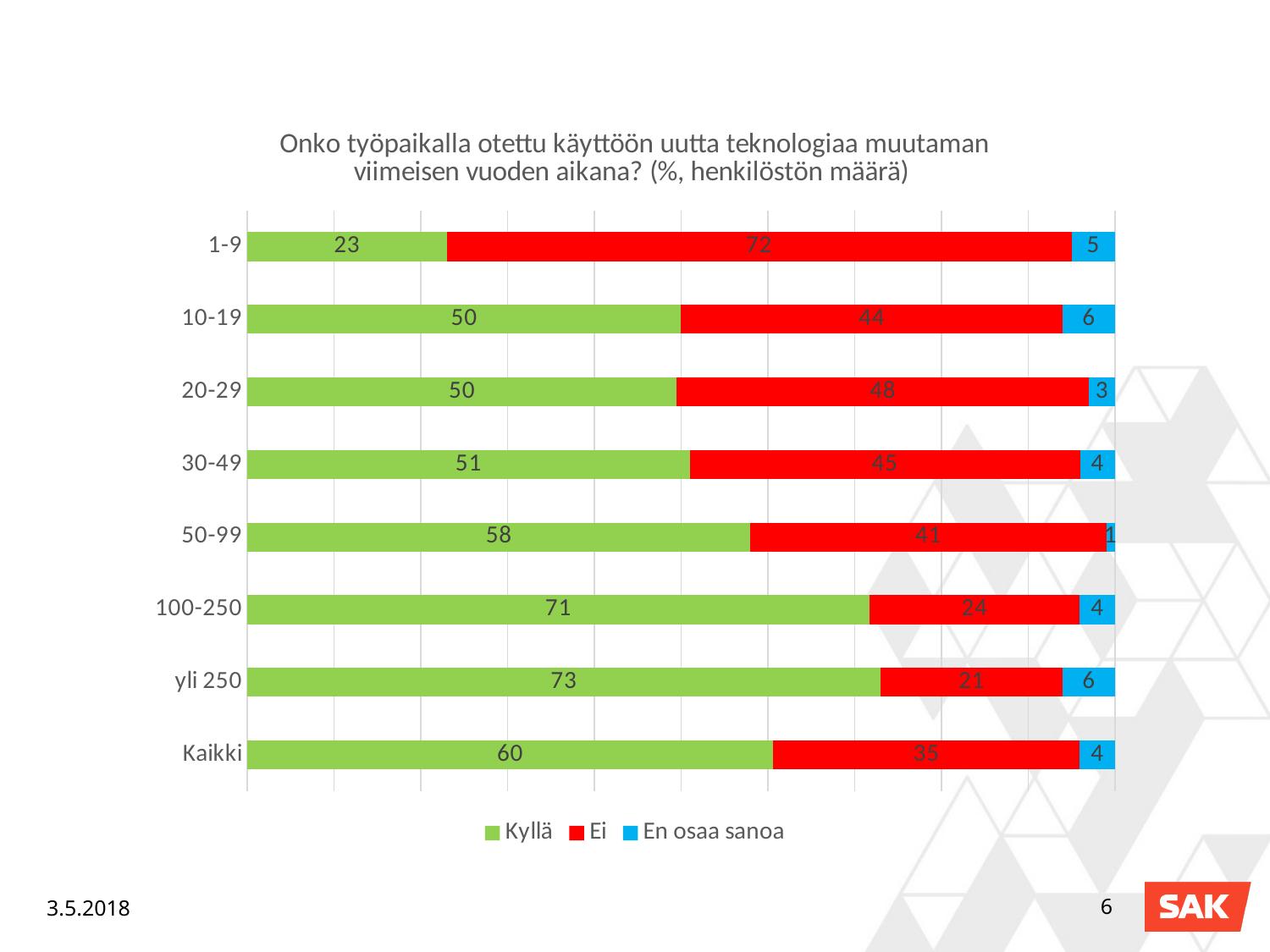
What is the En osaa sanoa value for the 10-19 category? 6 What kind of chart is shown on the slide? Stacked bar chart Which is larger, the Kyllä value for 100-250 or the Kyllä value for 50-99? 100-250 Which category has the lowest Kyllä value? 1-9 What is the difference between the Ei values for 1-9 and Kaikki? 37 What is the total of the stacked bar for the 30-49 category? 100 How many categories are shown on the vertical axis? 8 Which category has the highest Kyllä value? yli 250 How many series does the legend list? 3 Which series is shown in red in the legend? Ei What is the Ei value for the yli 250 category? 21 What is the Kyllä value for the 1-9 category? 23